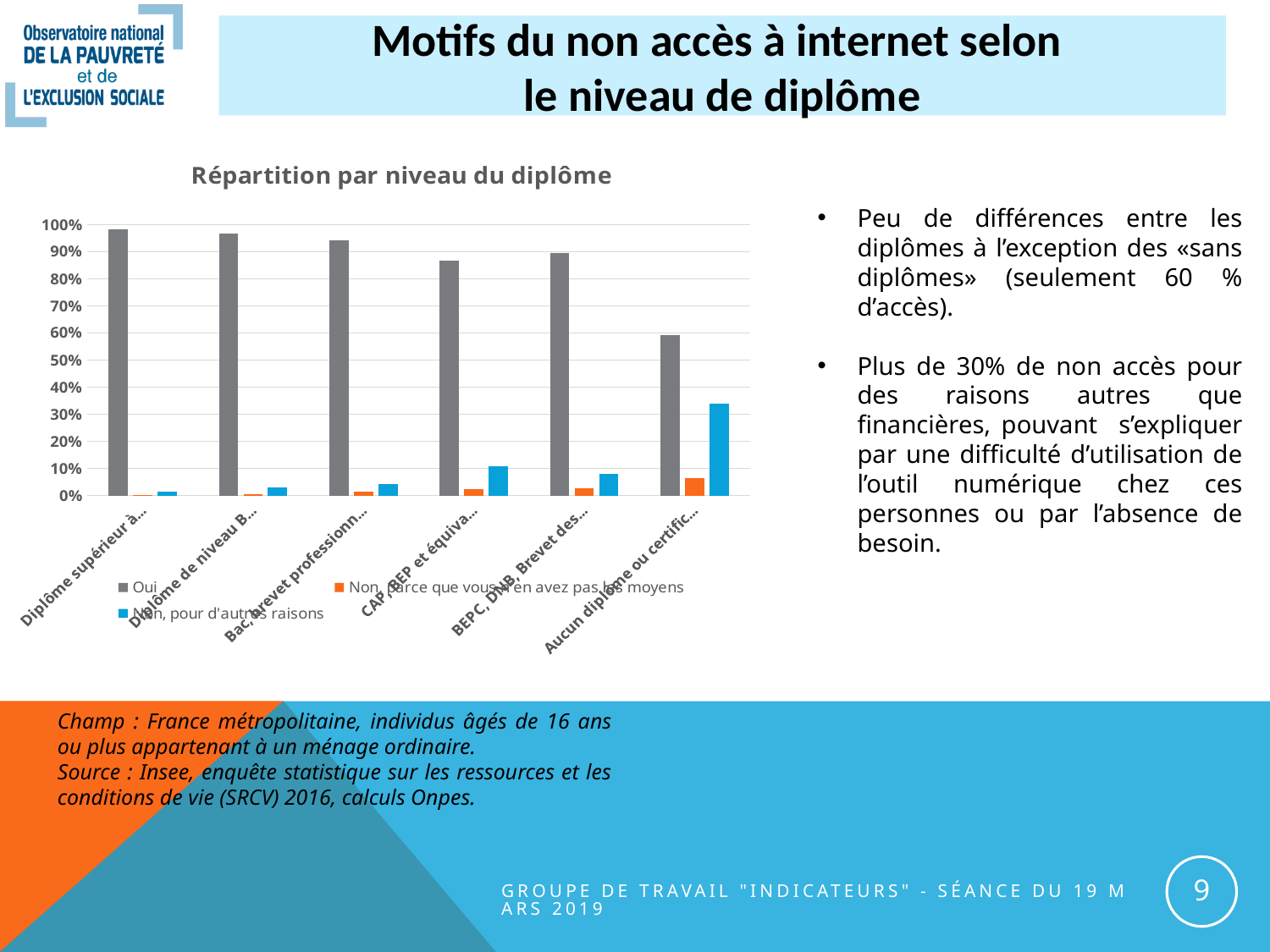
Which series is shown in gray in the chart? Oui For which category is the 'Oui' bar the lowest? Aucun diplôme ou certific... For 'Aucun diplôme ou certific...', which is larger: 'Non, parce que vous n'en avez pas les moyens' or 'Non, pour d'autres raisons'? Non, pour d'autres raisons Is the 'Oui' value for 'Aucun diplôme ou certific...' greater or less than 50%? greater For which category is the 'Non, pour d'autres raisons' bar the highest? Aucun diplôme ou certific... How many series does the chart legend list? 3 What kind of chart is shown on the slide? bar chart Is the 'Oui' value for 'CAP, BEP et équiva...' greater or less than 90%? less Is the 'Oui' value for 'Diplôme supérieur à...' greater or less than 90%? greater What is the title of the chart? Répartition par niveau du diplôme How many diploma-level categories are plotted on the x axis? 6